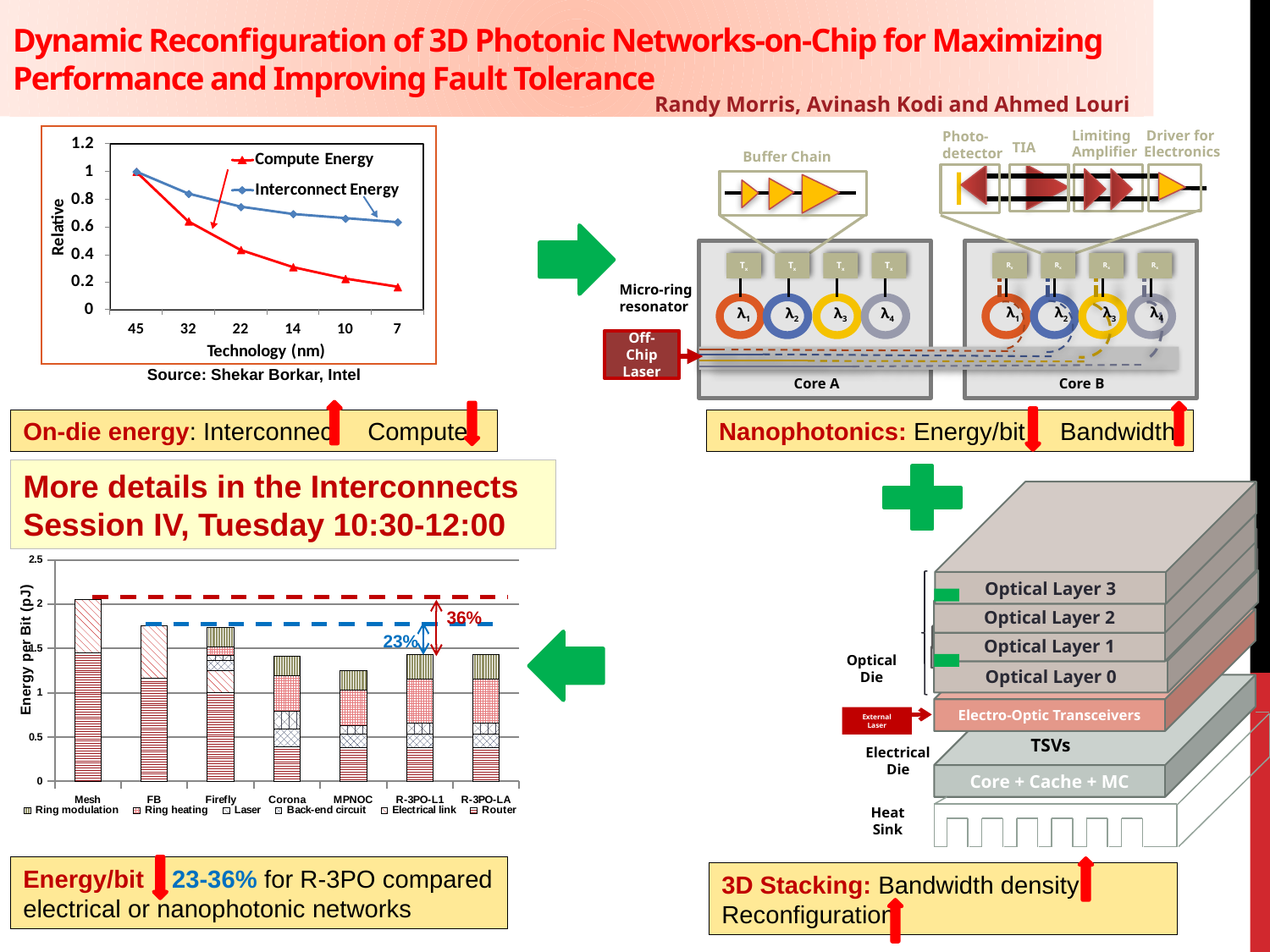
In the bottom-left Energy per Bit chart, which network has the highest total energy per bit? Mesh In the bottom-left Energy per Bit chart, is the total energy per bit for MPNOC greater or less than 1.5? less In the top-left chart of energy versus technology node, is the Interconnect Energy at 7 nm greater or less than 0.6? greater In the bottom-left Energy per Bit chart, how many series does the legend list? 6 In the top-left chart of energy versus technology node, what is the x-axis title? Technology (nm) In the top-left chart of energy versus technology node, what is the relative Compute Energy at 45 nm? 1 In the top-left chart of energy versus technology node, which series is higher at 22 nm, Compute Energy or Interconnect Energy? Interconnect Energy In the bottom-left Energy per Bit chart, how many network categories are shown on the x axis? 7 In the top-left chart of energy versus technology node, what kind of chart is it? line chart In the top-left chart of energy versus technology node, how many series does the legend list? 2 In the top-left chart of energy versus technology node, do the Compute Energy values rise or fall as the technology node moves from 45 nm to 7 nm? fall In the top-left chart of energy versus technology node, is the Compute Energy at 7 nm greater or less than 0.2? less